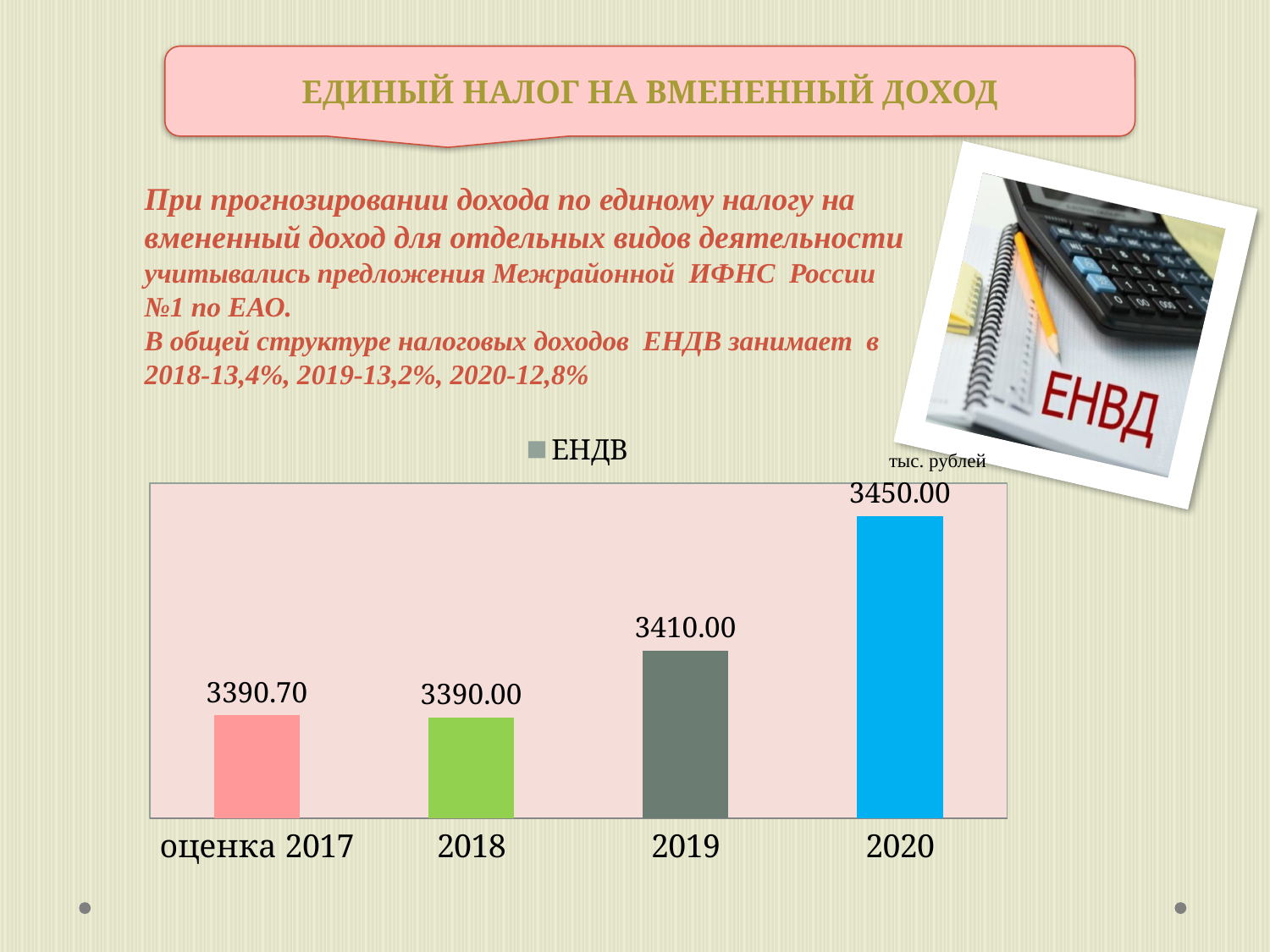
What kind of chart is shown on the slide? bar chart What is the value for 2019 in the ЕНДВ chart? 3410.00 What is the difference between the values for 2020 and 2019 in the ЕНДВ chart? 40.00 Which is larger in the ЕНДВ chart, the value for 2019 or the value for 2018? 2019 What unit is indicated for the values in the ЕНДВ chart? тыс. рублей What is the value for 2020 in the ЕНДВ chart? 3450.00 How many categories are shown on the x axis of the ЕНДВ chart? 4 Which category has the highest value in the ЕНДВ chart? 2020 What is the value for оценка 2017 in the ЕНДВ chart? 3390.70 Which category has the lowest value in the ЕНДВ chart? 2018 What is the value for 2018 in the ЕНДВ chart? 3390.00 What is the difference between the values for оценка 2017 and 2018 in the ЕНДВ chart? 0.70